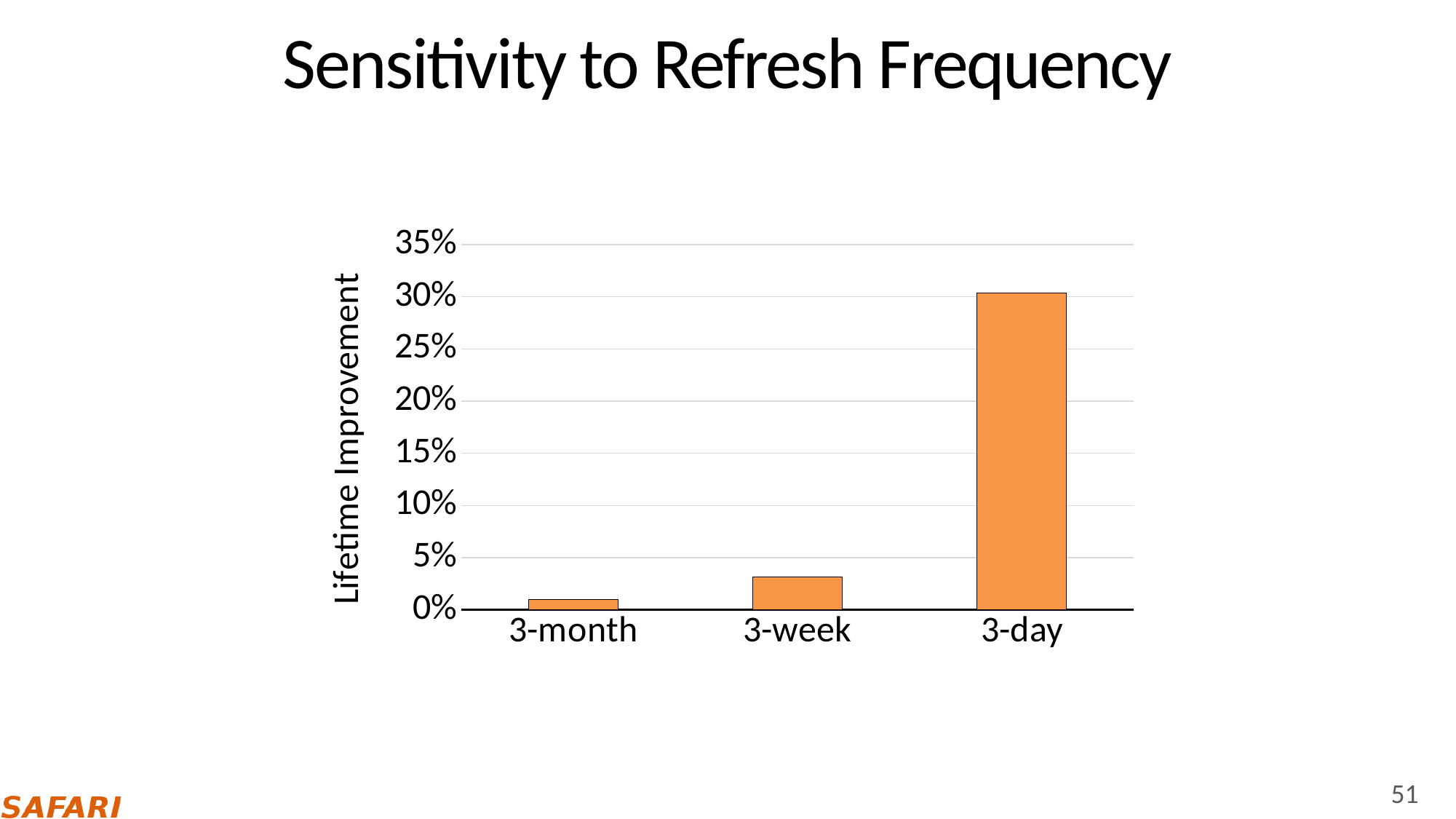
Which refresh frequency has the highest lifetime improvement? 3-day Which has a larger lifetime improvement, 3-week or 3-month? 3-week How many categories are shown on the x axis? 3 Is the lifetime improvement for 3-day greater or less than 35%? less Is the lifetime improvement for 3-week greater or less than 5%? less Which refresh frequency has the lowest lifetime improvement? 3-month What is the label of the y axis? Lifetime Improvement Is the lifetime improvement for 3-month greater or less than 5%? less What is the title of the slide? Sensitivity to Refresh Frequency Do the values rise or fall moving from 3-month to 3-day along the x axis? rise What kind of chart is shown on the slide? bar chart